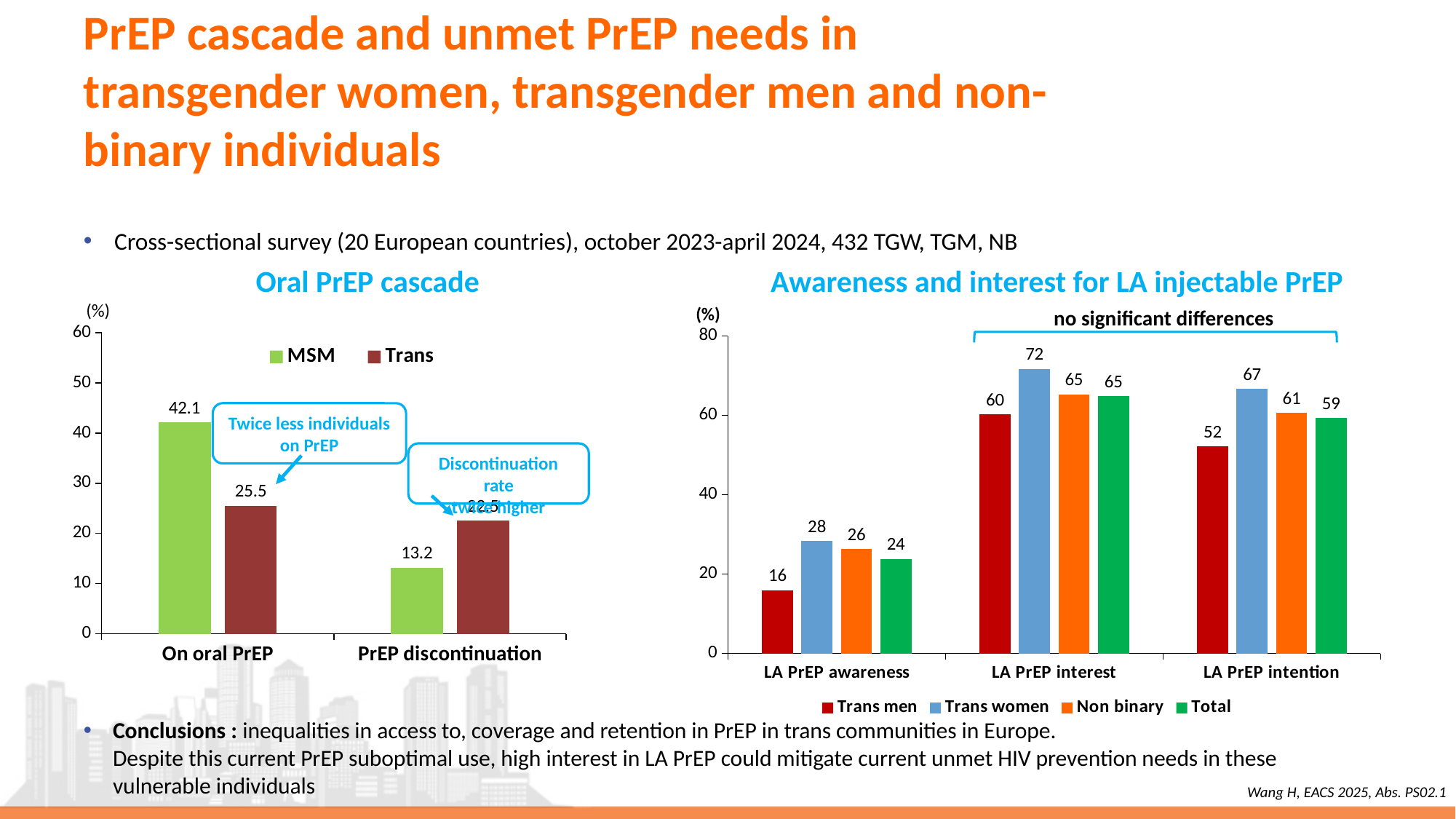
In the 'Awareness and interest for LA injectable PrEP' chart, what is the value for Trans women in 'LA PrEP interest'? 72 In the 'Awareness and interest for LA injectable PrEP' chart, what is the value for Trans men in 'LA PrEP awareness'? 16 In the 'Awareness and interest for LA injectable PrEP' chart, how many series does the legend list? 4 In the 'Awareness and interest for LA injectable PrEP' chart, which group has the highest value for 'LA PrEP awareness'? Trans women In the 'Awareness and interest for LA injectable PrEP' chart, which group has the lowest value for 'LA PrEP intention'? Trans men What kind of chart is the 'Awareness and interest for LA injectable PrEP' chart? Bar chart In the 'Oral PrEP cascade' chart, what is the difference between the MSM and Trans values for 'On oral PrEP'? 16.6 In the 'Oral PrEP cascade' chart, what is the value for MSM in the 'On oral PrEP' category? 42.1 In the 'Oral PrEP cascade' chart, is the Trans value for 'PrEP discontinuation' greater or less than 20? greater In the 'Oral PrEP cascade' chart, what is the value for Trans in the 'On oral PrEP' category? 25.5 In the 'Oral PrEP cascade' chart, how many series does the legend list? 2 In the 'Awareness and interest for LA injectable PrEP' chart, what is the difference between the Trans women and Trans men values for 'LA PrEP intention'? 15